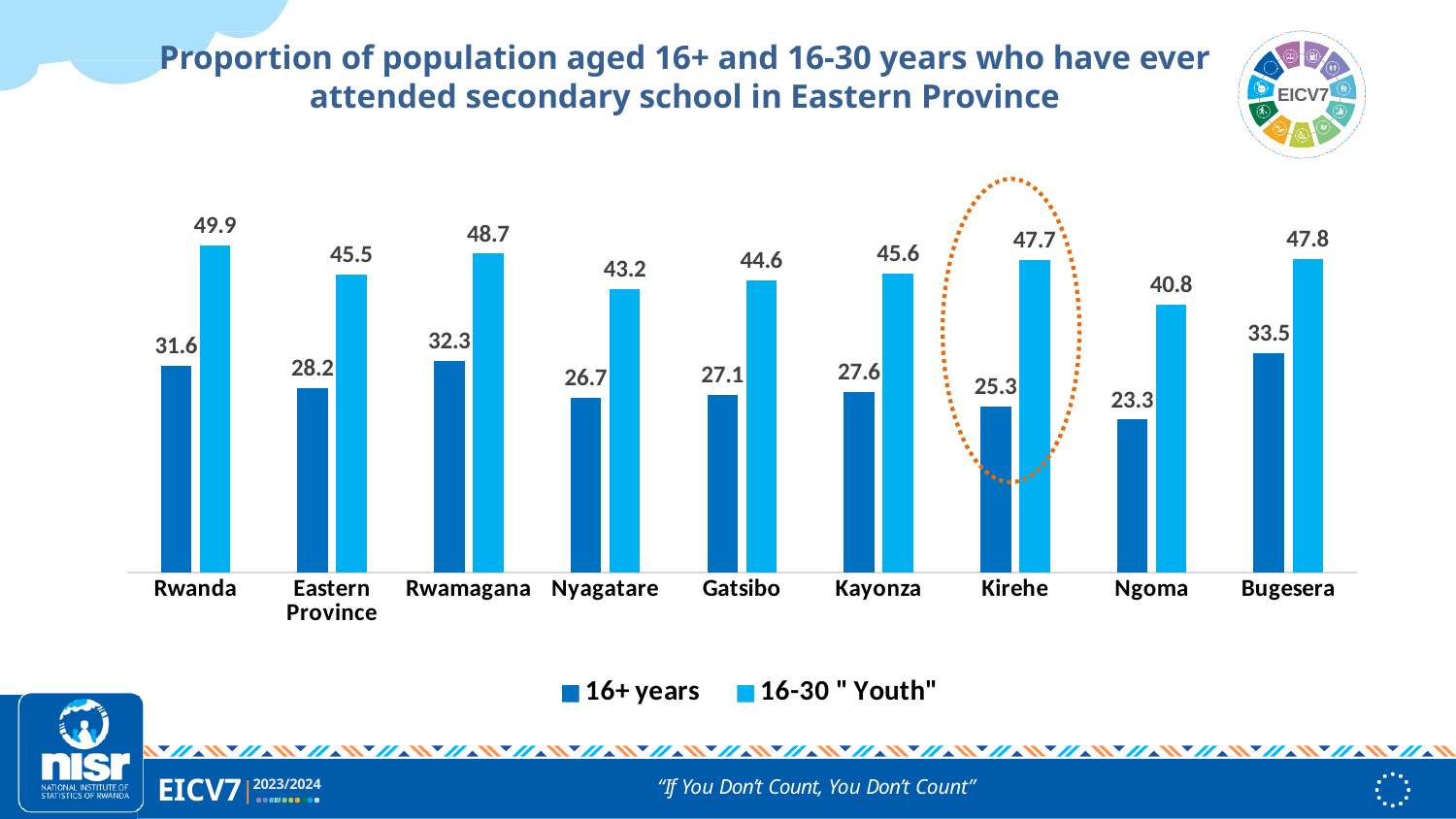
How many series does the legend list? 2 Which category has the lowest value in the 16+ years series? Ngoma What kind of chart is shown on the slide? Bar chart How many categories are shown on the x axis? 9 What is the value for Kirehe in the 16-30 "Youth" series? 47.7 Which is larger, the 16+ years value for Rwamagana or for Nyagatare? Rwamagana What is the value for Ngoma in the 16+ years series? 23.3 What is the difference between the 16-30 "Youth" value and the 16+ years value for Kirehe? 22.4 Which category has the lowest value in the 16-30 "Youth" series? Ngoma Which category has the highest value in the 16+ years series? Bugesera What is the value for Rwanda in the 16-30 "Youth" series? 49.9 What is the difference between the 16-30 "Youth" values for Rwanda and Ngoma? 9.1